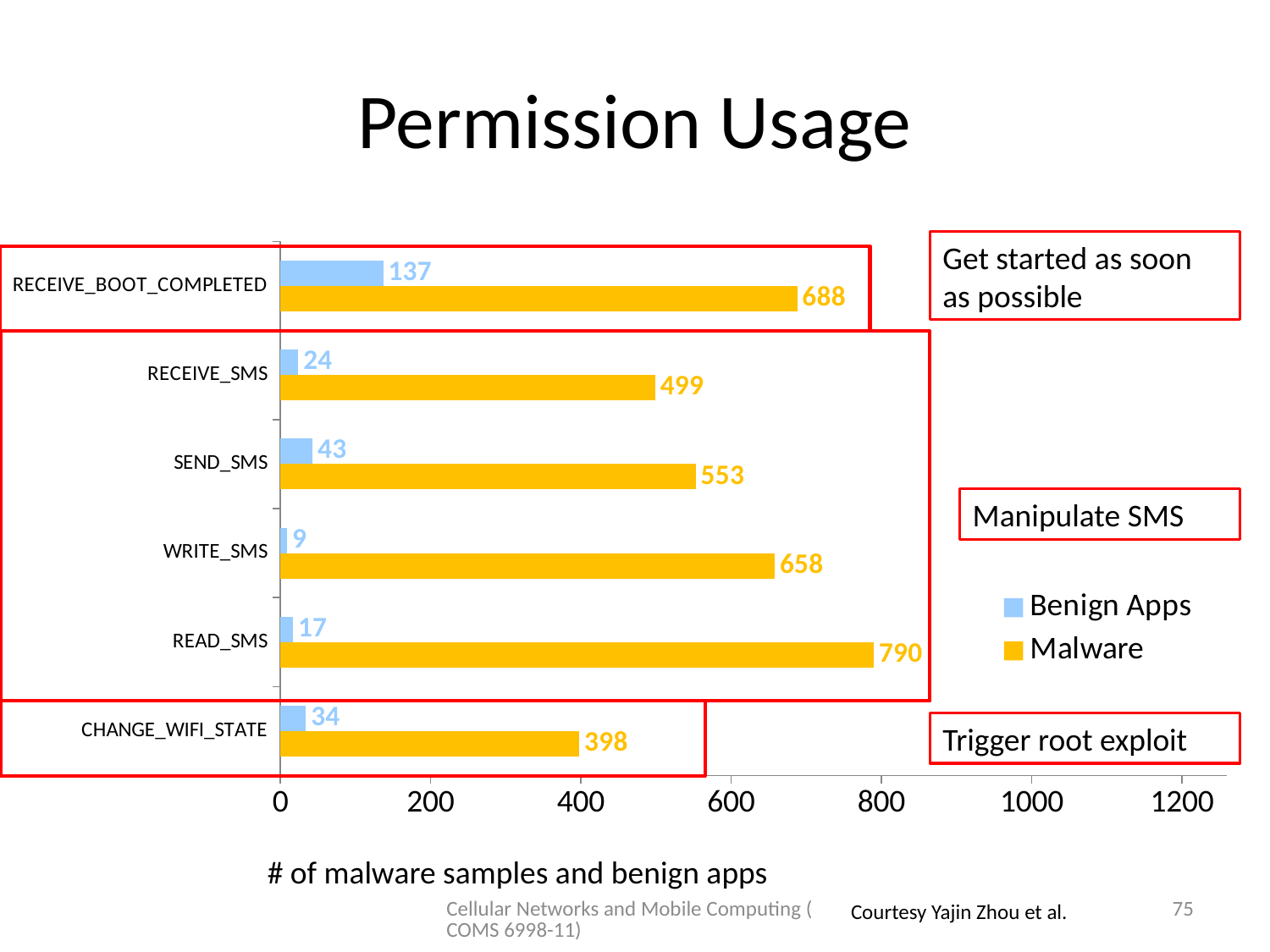
How many permissions are shown on the chart? 6 Which permission has the highest Malware value? READ_SMS What is the Malware value for CHANGE_WIFI_STATE? 398 What is the difference between the Malware and Benign Apps values for SEND_SMS? 510 What is the x-axis label of the chart? # of malware samples and benign apps What is the Benign Apps value for RECEIVE_BOOT_COMPLETED? 137 How many series does the legend list? 2 What kind of chart is shown on the slide? Bar chart Which permission has the lowest Benign Apps value? WRITE_SMS What is the Malware value for READ_SMS? 790 Which is larger, the Malware value for RECEIVE_SMS or the Malware value for WRITE_SMS? WRITE_SMS Which colour represents Malware in the chart? Orange